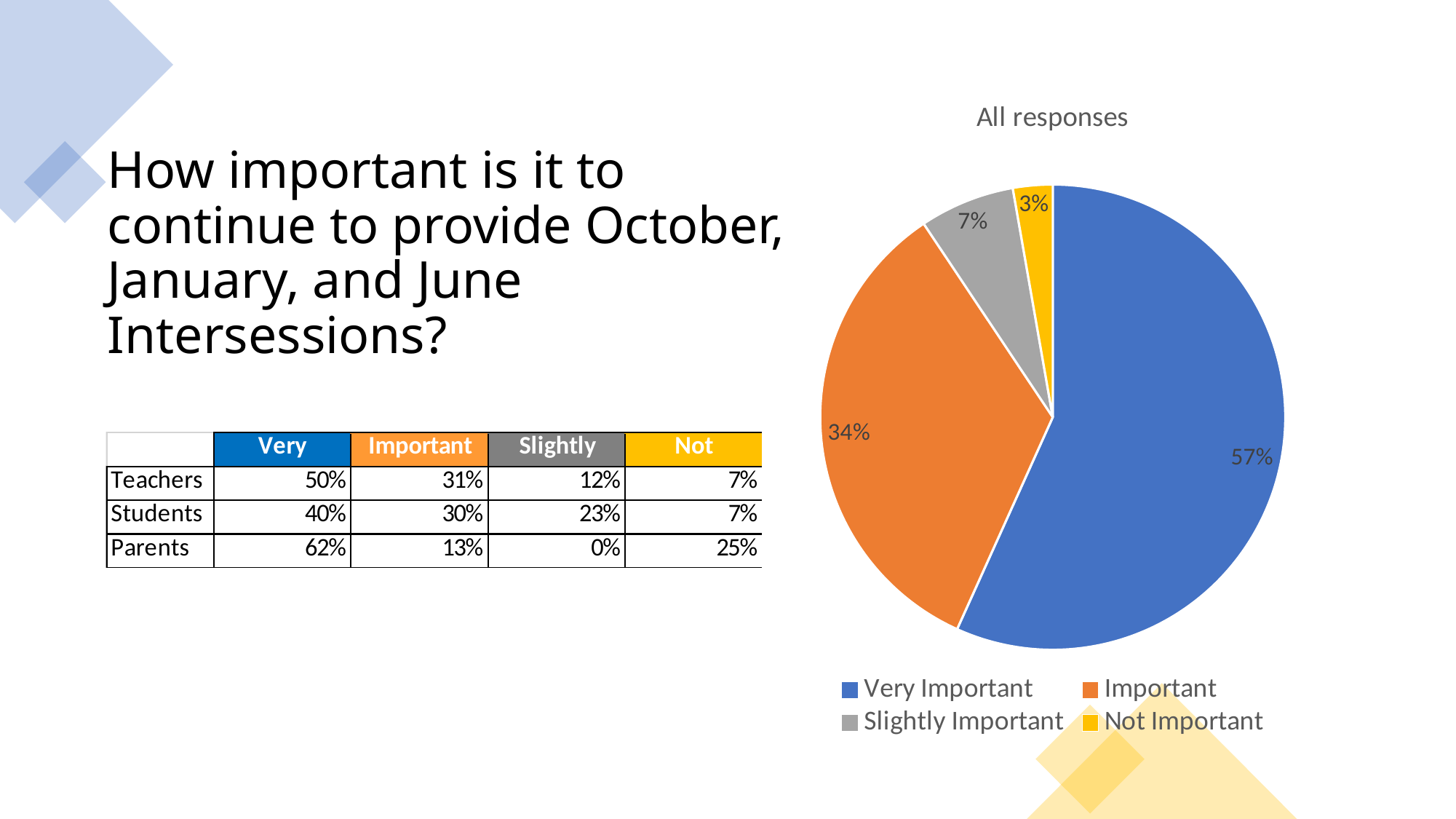
How many slices does the pie chart have? 4 What colour is the Important slice in the pie chart? orange What kind of chart is shown on the slide? pie chart What is the title of the pie chart? All responses Which category has the largest slice of the pie? Very Important Which category has the smallest slice of the pie? Not Important Which slice is larger, Slightly Important or Not Important? Slightly Important What share of the pie does Important take? 34% What share of the pie does Very Important take? 57% What is the difference in percentage points between the Very Important and Important slices? 23 What share of the pie does Not Important take? 3%